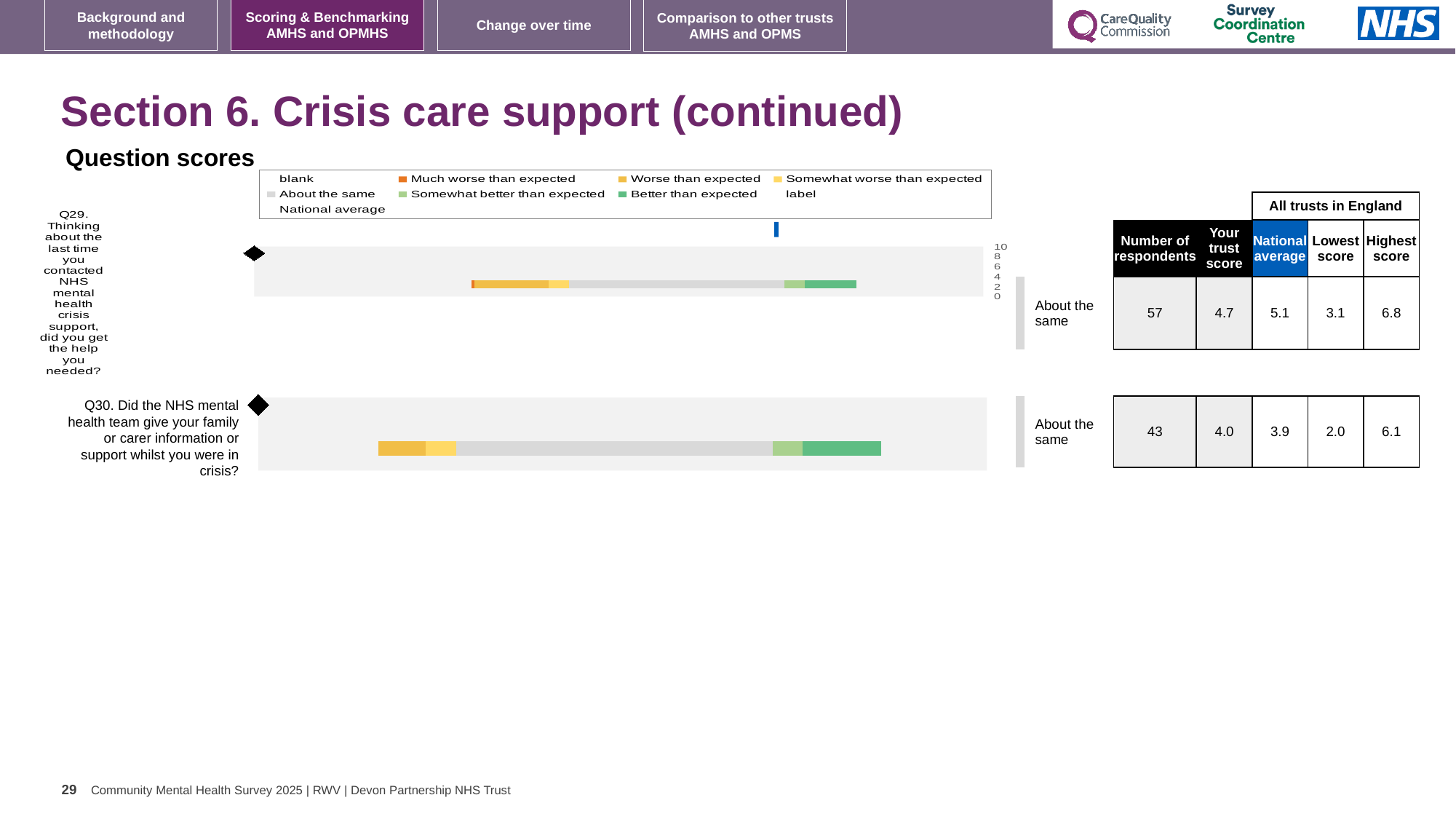
For Q30, which is larger: the trust score or the national average? trust score What colour does the legend use for 'Better than expected'? green How many questions are plotted in the question scores chart? 2 What is the trust score for Q29 (did you get the help you needed)? 4.7 What benchmark category is shown next to the bar for Q30? About the same What is the national average for Q30 (family or carer information or support)? 3.9 What is the difference between the highest score and the lowest score for Q30? 4.1 What kind of chart is used to show the question scores on this slide? bar chart What is the difference between the highest score and the lowest score for Q29? 3.7 For Q29, which is larger: the trust score or the national average? national average What is the lowest score among all trusts in England for Q30? 2.0 How many respondents answered Q29? 57